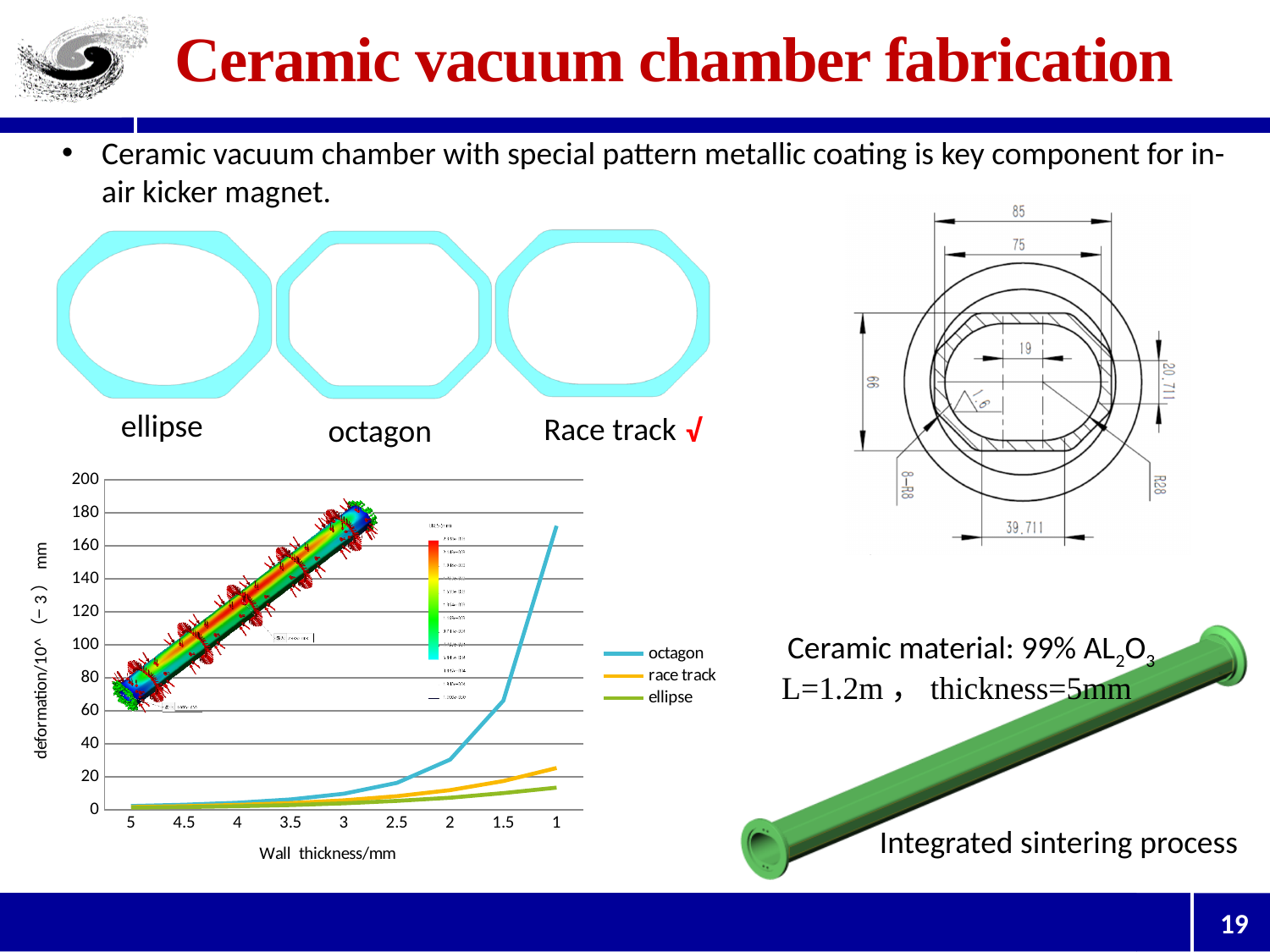
Which colour is used for the octagon series in the chart? blue What kind of chart is shown on the slide? line chart How many series does the chart legend list? 3 At a wall thickness of 1 mm, which is larger, the deformation for octagon or for race track? octagon Do the deformation values rise or fall as the wall thickness decreases from 5 mm to 1 mm along the x axis? rise Is the deformation for octagon at a wall thickness of 1 mm greater or less than 160? greater What is the x-axis title of the chart? Wall thickness/mm Which series has the lowest deformation at a wall thickness of 1 mm? ellipse Which series has the highest deformation at a wall thickness of 1 mm? octagon How many wall thickness values are marked on the x axis of the chart? 9 Is the deformation for octagon at a wall thickness of 2 mm greater or less than 40? less Is the deformation for ellipse at a wall thickness of 1 mm greater or less than 20? less